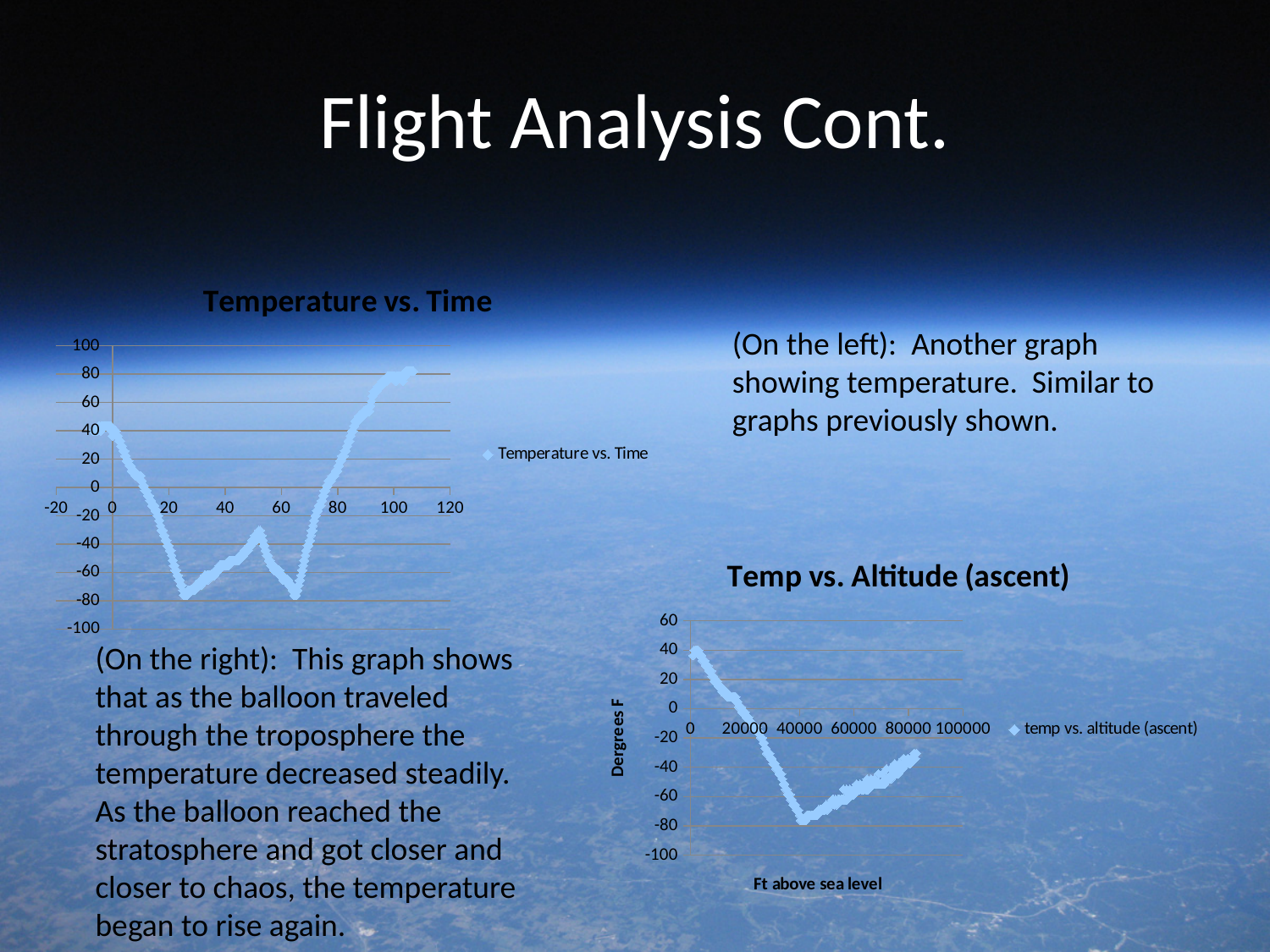
In the "Temp vs. Altitude (ascent)" chart, what is the label on the vertical axis? Dergrees F In the "Temp vs. Altitude (ascent)" chart, does the temperature rise or fall as altitude increases from 0 to 40000 ft? fall What kind of chart is the "Temperature vs. Time" chart on the left? scatter chart In the "Temp vs. Altitude (ascent)" chart, is the temperature at 0 ft above sea level greater or less than 20? greater In the "Temperature vs. Time" chart, is the lowest temperature reached (around time 25) greater or less than -60? less In the "Temp vs. Altitude (ascent)" chart, is the lowest temperature (around 40000 ft) greater or less than -60? less What kind of chart is the "Temp vs. Altitude (ascent)" chart on the right? scatter chart How many series does the legend of the "Temperature vs. Time" chart list? 1 In the "Temp vs. Altitude (ascent)" chart, what is the label on the horizontal axis? Ft above sea level How many series does the legend of the "Temp vs. Altitude (ascent)" chart list? 1 In the "Temperature vs. Time" chart, does the temperature rise or fall as time increases from 60 to 100? rise